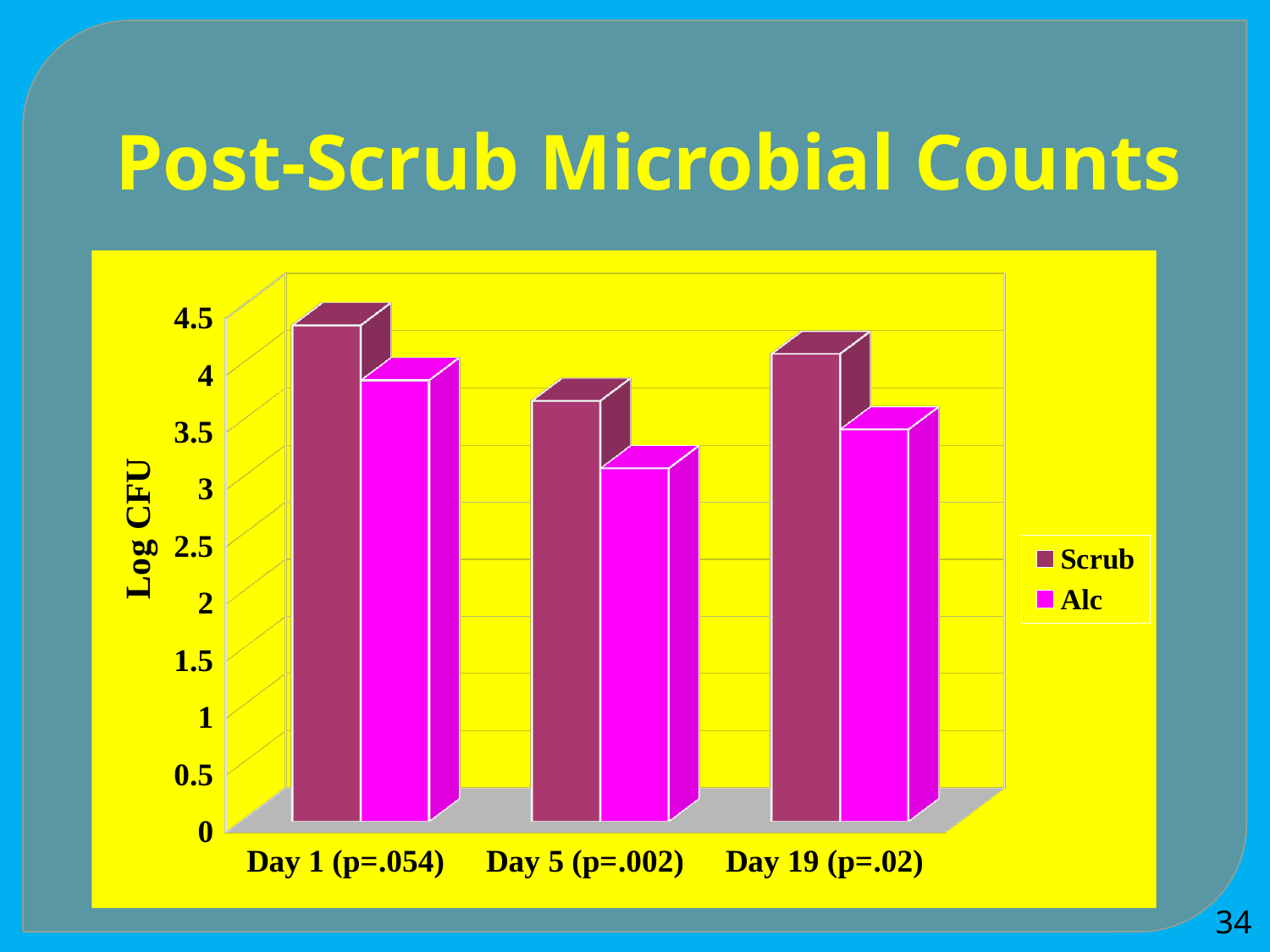
For which day is the Scrub value highest? Day 1 (p=.054) Is the Alc value for Day 19 (p=.02) greater or less than 4? less Is the Scrub value for Day 5 (p=.002) greater or less than 3.5? greater Is the Alc value for Day 5 (p=.002) greater or less than 3.5? less What kind of chart is shown on the slide? bar chart How many series does the legend list? 2 What are the two series named in the legend? Scrub and Alc For which day is the Alc value lowest? Day 5 (p=.002) What is the label on the vertical axis? Log CFU At Day 5 (p=.002), which series has the larger value, Scrub or Alc? Scrub How many day categories are shown on the x axis? 3